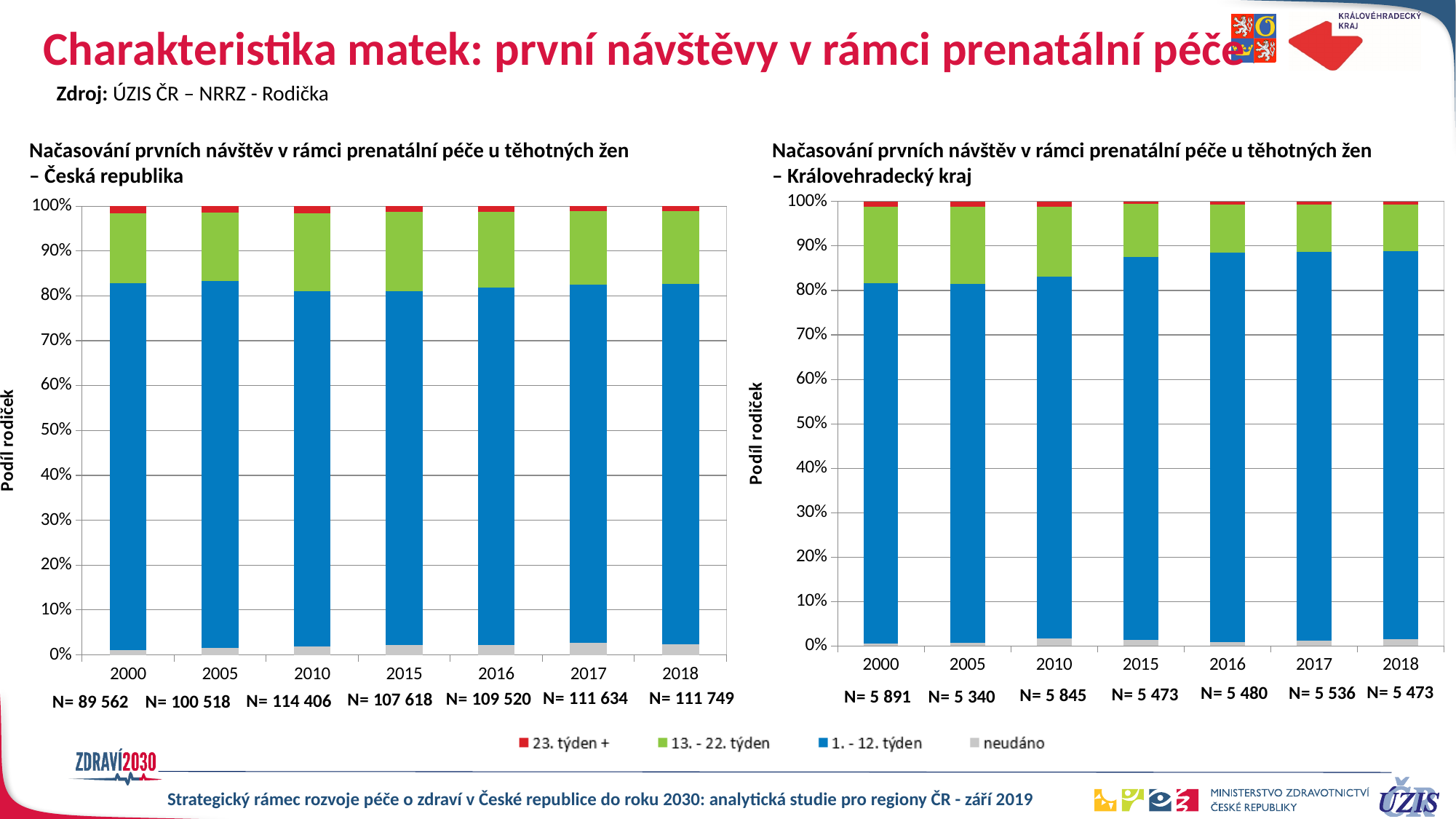
Which colour represents '23. týden +' in the legend? Red In the Česká republika chart, what is the N value printed under 2010? N= 114 406 What type of chart is used on the left for 'Načasování prvních návštěv v rámci prenatální péče u těhotných žen – Česká republika'? Stacked bar chart In the Královehradecký kraj chart, which year has the lowest printed N value? 2005 In the Královehradecký kraj chart, does the share of '1. - 12. týden' rise or fall from 2000 to 2018? rise In the Královehradecký kraj chart, what is the N value printed under 2005? N= 5 340 In the Česká republika chart, which year has the highest printed N value? 2010 In the Královehradecký kraj chart, what is the difference between the N values for 2000 and 2018? 418 In the Královehradecký kraj chart, is the share of '1. - 12. týden' larger in 2000 or in 2018? 2018 In the Královehradecký kraj chart, is the top of the blue '1. - 12. týden' segment for 2018 greater or less than 80%? greater In the Česká republika chart, how many years are shown on the x axis? 7 How many series does the shared legend list? 4